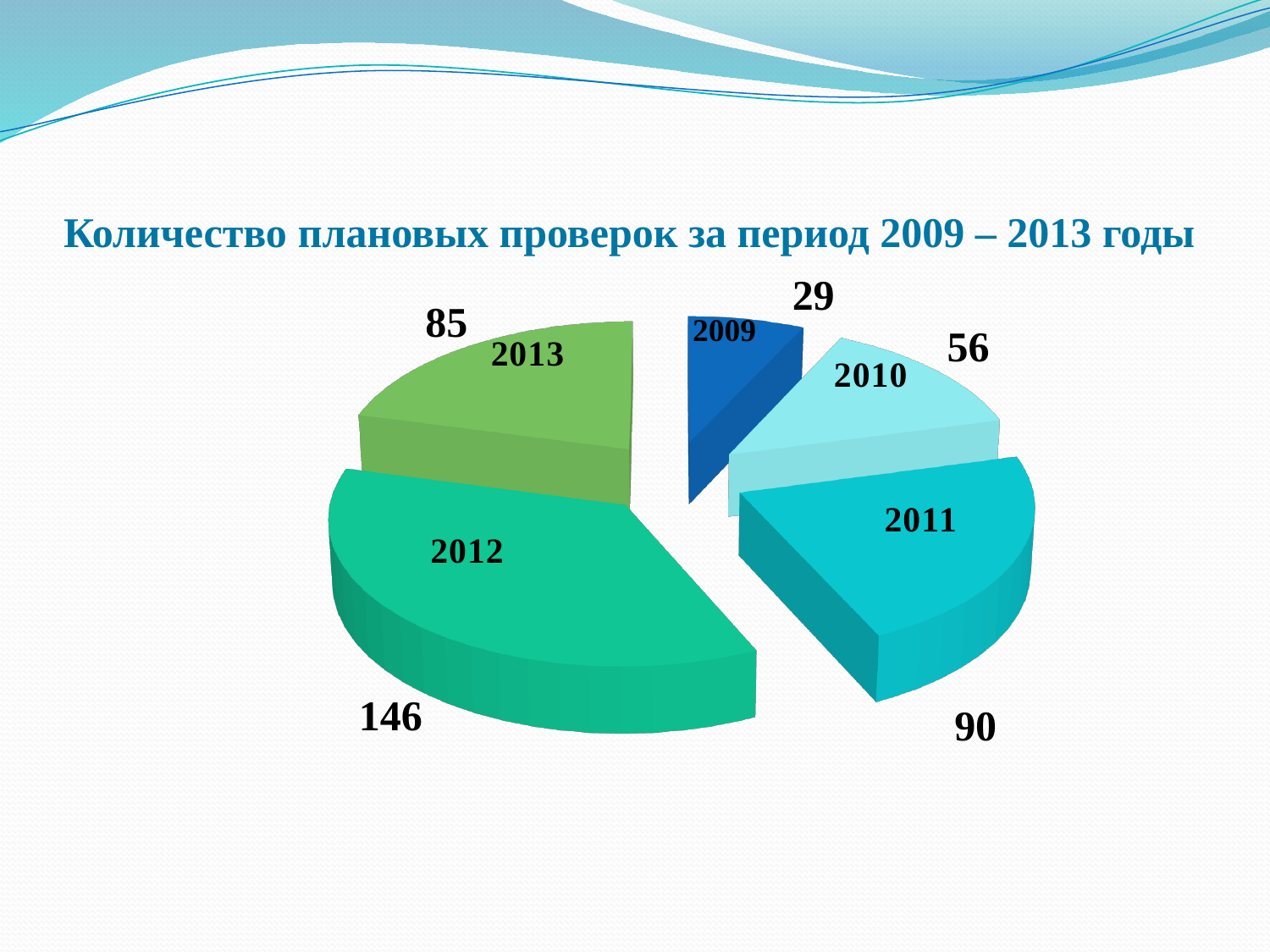
What is the value for 2009 in the pie chart? 29 What is the value for 2011 in the pie chart? 90 What is the difference between the values for 2012 and 2011? 56 What is the value for 2013 in the pie chart? 85 Which year has the largest slice in the pie chart? 2012 Which year has the smallest slice in the pie chart? 2009 What is the value for 2012 in the pie chart? 146 What kind of chart is shown on the slide? pie chart Which is larger, the value for 2011 or the value for 2013? 2011 How many slices does the pie chart have? 5 What is the difference between the values for 2010 and 2009? 27 What is the title of the chart? Количество плановых проверок за период 2009 – 2013 годы